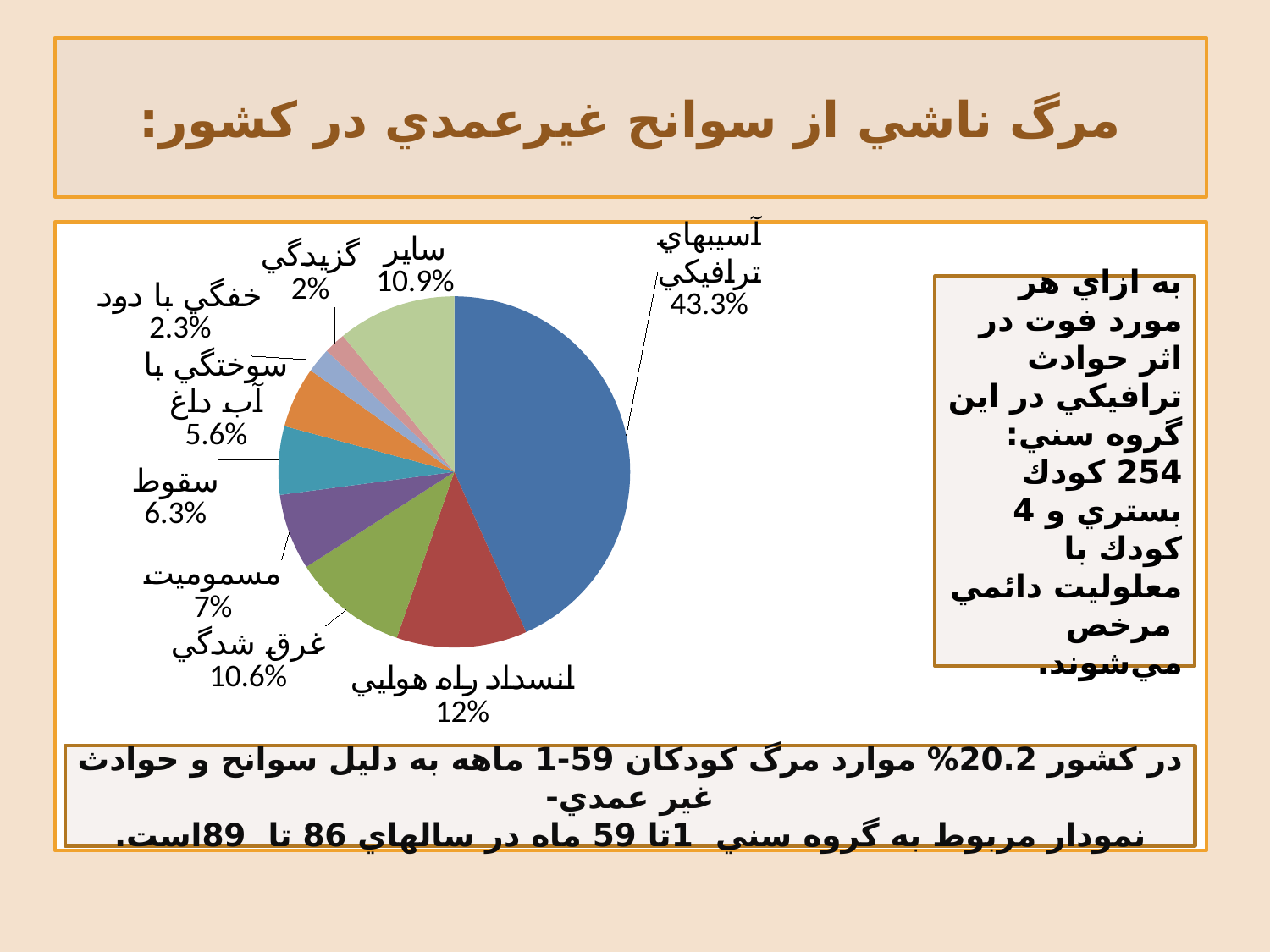
Which is larger, the share for مسمومیت or the share for سوختگي با آب داغ? مسمومیت What percentage does the slice for انسداد راه هوايي show? 12% What percentage does the slice for غرق شدگي show? 10.6% What percentage does the slice for خفگي با دود show? 2.3% What kind of chart is shown on the slide? pie chart Which category has the largest share of the pie? آسيبهاي ترافيكي What percentage does the slice for سقوط show? 6.3% What is the title of the slide containing the pie chart? مرگ ناشي از سوانح غيرعمدي در كشور: How many slices does the pie chart have? 9 What percentage does the slice for آسيبهاي ترافيكي show? 43.3% Which category has the smallest share of the pie? گزيدگي What is the difference in percentage points between آسيبهاي ترافيكي and انسداد راه هوايي? 31.3